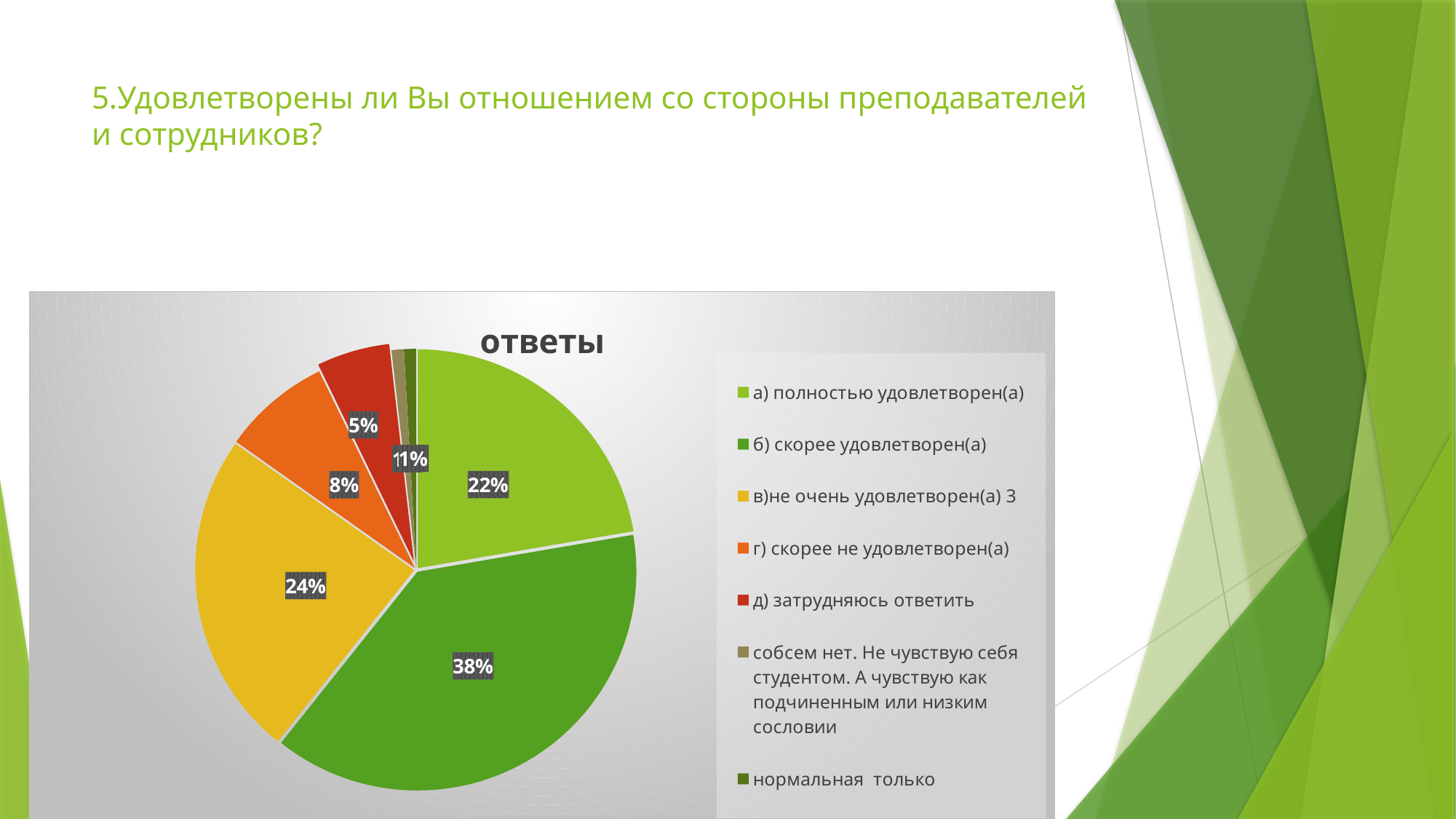
What share of the pie is labelled for 'а) полностью удовлетворен(а)'? 22% Which is larger: the slice for 'в)не очень удовлетворен(а)' or the slice for 'а) полностью удовлетворен(а)'? в)не очень удовлетворен(а) What is the title of the chart? ответы What share of the pie is labelled for 'д) затрудняюсь ответить'? 5% What colour is the slice for 'д) затрудняюсь ответить'? red How many entries does the chart legend list? 7 What share of the pie is labelled for 'б) скорее удовлетворен(а)'? 38% Which answer option has the largest slice of the pie? б) скорее удовлетворен(а) What share of the pie is labelled for 'г) скорее не удовлетворен(а)'? 8% What type of chart is shown on the slide? pie chart What is the difference in percentage points between 'б) скорее удовлетворен(а)' and 'а) полностью удовлетворен(а)'? 16% What share of the pie is labelled for 'в)не очень удовлетворен(а)'? 24%